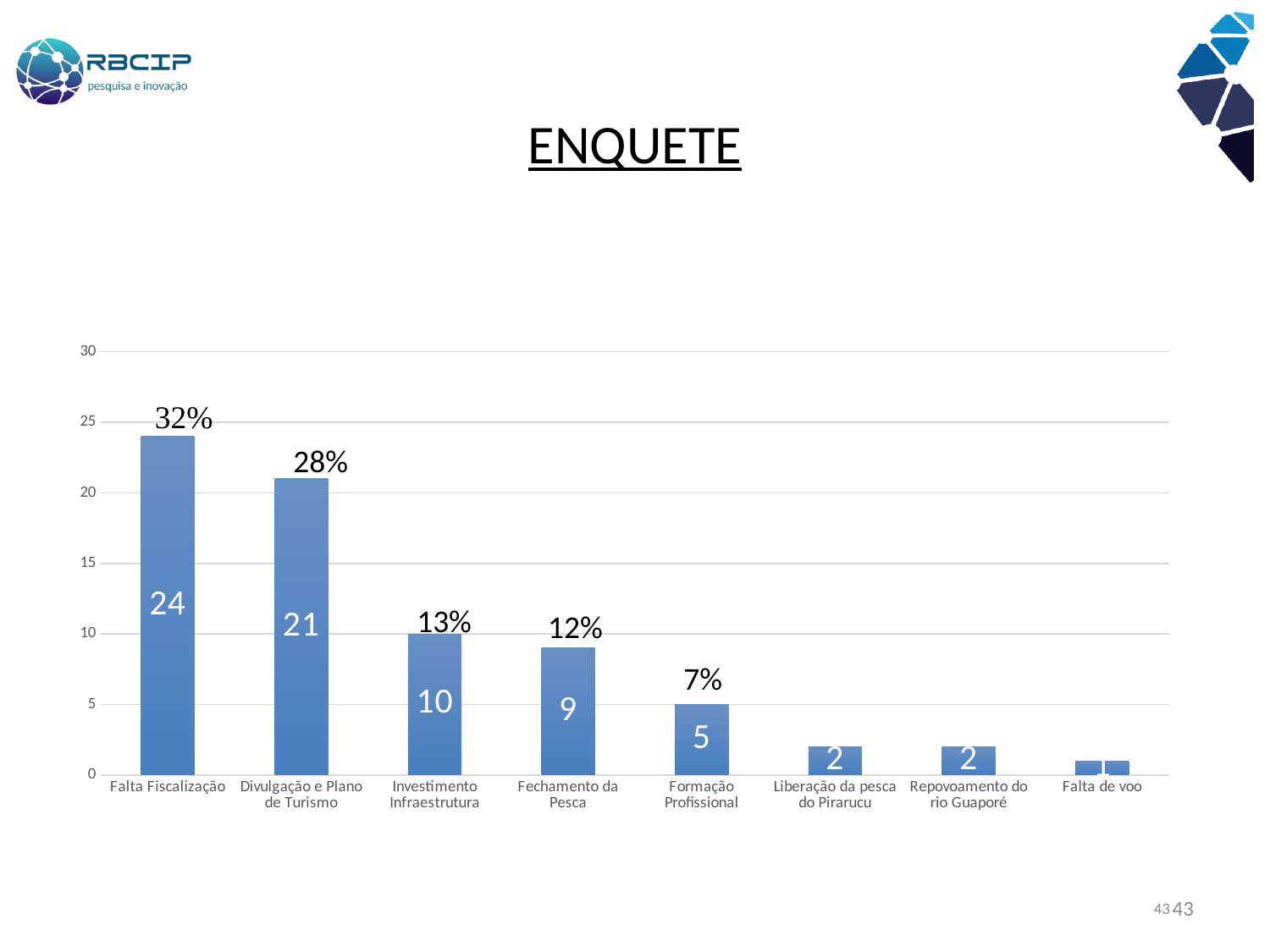
Is the value for Falta de voo greater or less than 5? less What is the value for Formação Profissional? 5 What is the value for Falta Fiscalização? 24 Which category has the highest value? Falta Fiscalização What is the title of the slide? ENQUETE How many categories are shown on the x axis? 8 What is the value for Divulgação e Plano de Turismo? 21 What percentage is shown above the bar for Fechamento da Pesca? 12% What kind of chart is shown on the slide? bar chart What is the difference between the values for Falta Fiscalização and Divulgação e Plano de Turismo? 3 Which is larger, the value for Investimento Infraestrutura or the value for Fechamento da Pesca? Investimento Infraestrutura What percentage is shown above the bar for Investimento Infraestrutura? 13%